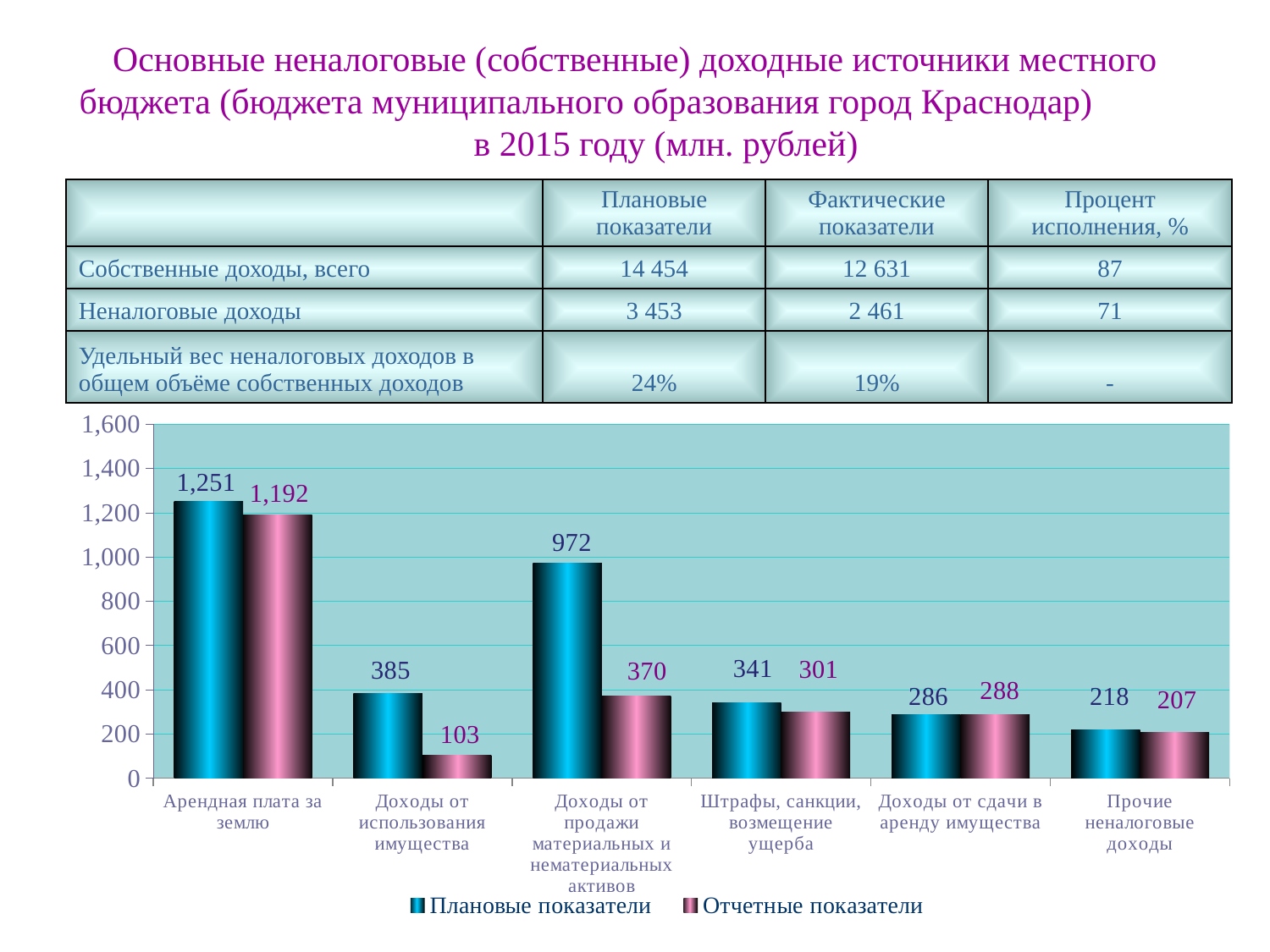
Which category has the highest reported value (Отчетные показатели)? Арендная плата за землю What is the planned value (Плановые показатели) for Арендная плата за землю? 1,251 What is the planned value (Плановые показатели) for Доходы от продажи материальных и нематериальных активов? 972 What is the difference between the planned and reported values for Доходы от продажи материальных и нематериальных активов? 602 Which category has the lowest planned value (Плановые показатели)? Прочие неналоговые доходы What is the reported value (Отчетные показатели) for Доходы от использования имущества? 103 How many categories are shown on the x axis of the chart? 6 Which is larger for Доходы от сдачи в аренду имущества: the planned value or the reported value? Reported value (288) What type of chart is shown on the slide? Bar chart How many series does the chart legend list? 2 What are the two series named in the chart legend? Плановые показатели and Отчетные показатели Is the planned value for Штрафы, санкции, возмещение ущерба greater or less than 400? less